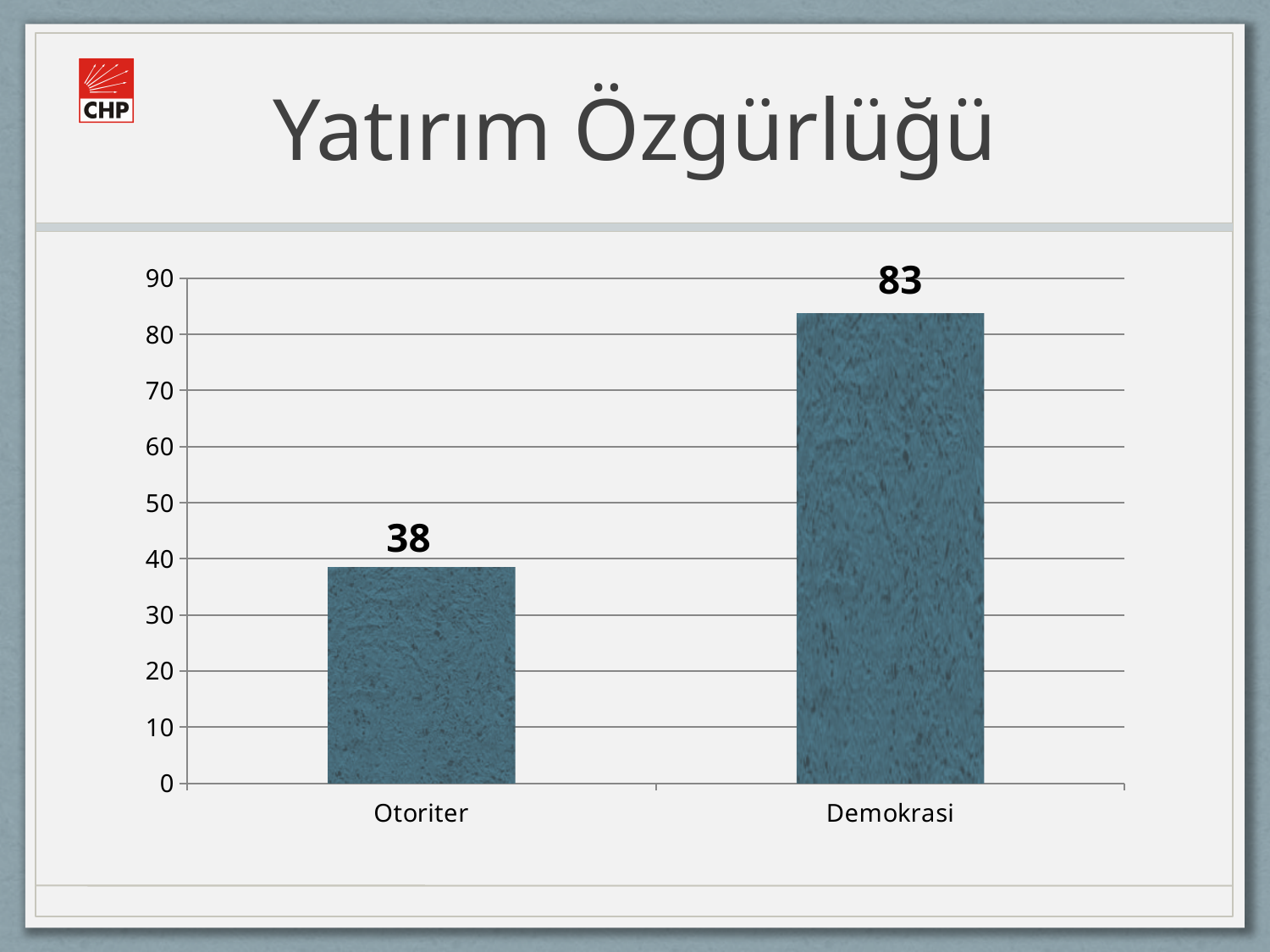
Is the value for Demokrasi greater or less than 80? greater How many categories are shown on the x axis? 2 Which is larger, the value for Otoriter or the value for Demokrasi? Demokrasi What is the title of the slide containing the chart? Yatırım Özgürlüğü Is the value for Otoriter greater or less than 40? less Which category has the lowest value? Otoriter What is the value for Otoriter? 38 Which category has the highest value? Demokrasi What is the highest value shown on the y axis? 90 What is the value for Demokrasi? 83 What kind of chart is shown on the slide? bar chart What is the difference between the values for Demokrasi and Otoriter? 45